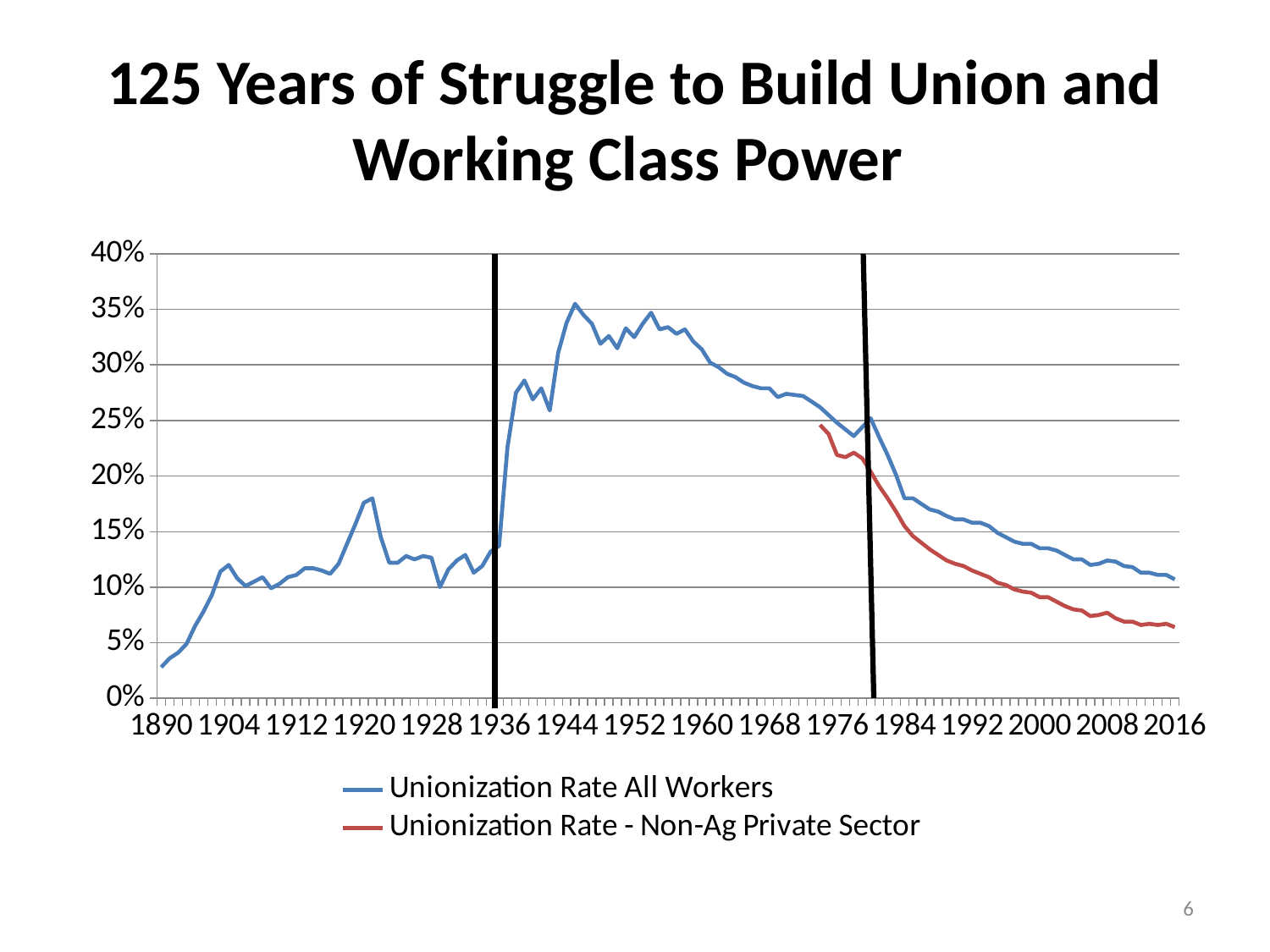
What are the two series named in the legend? Unionization Rate All Workers; Unionization Rate - Non-Ag Private Sector Does the Unionization Rate All Workers series rise or fall between 1936 and 1944? Rise Is the Unionization Rate - Non-Ag Private Sector value in 1976 greater or less than 20%? greater Is the peak Unionization Rate All Workers value in the mid-1940s greater or less than 30%? greater What kind of chart is shown on the slide? Line chart Does the Unionization Rate All Workers series rise or fall between 1984 and 2016? Fall Is the Unionization Rate All Workers value in 2016 greater or less than 15%? less How many series does the legend list? 2 What is the title of the slide containing the chart? 125 Years of Struggle to Build Union and Working Class Power In 2016, which series has the higher value: Unionization Rate All Workers or Unionization Rate - Non-Ag Private Sector? Unionization Rate All Workers